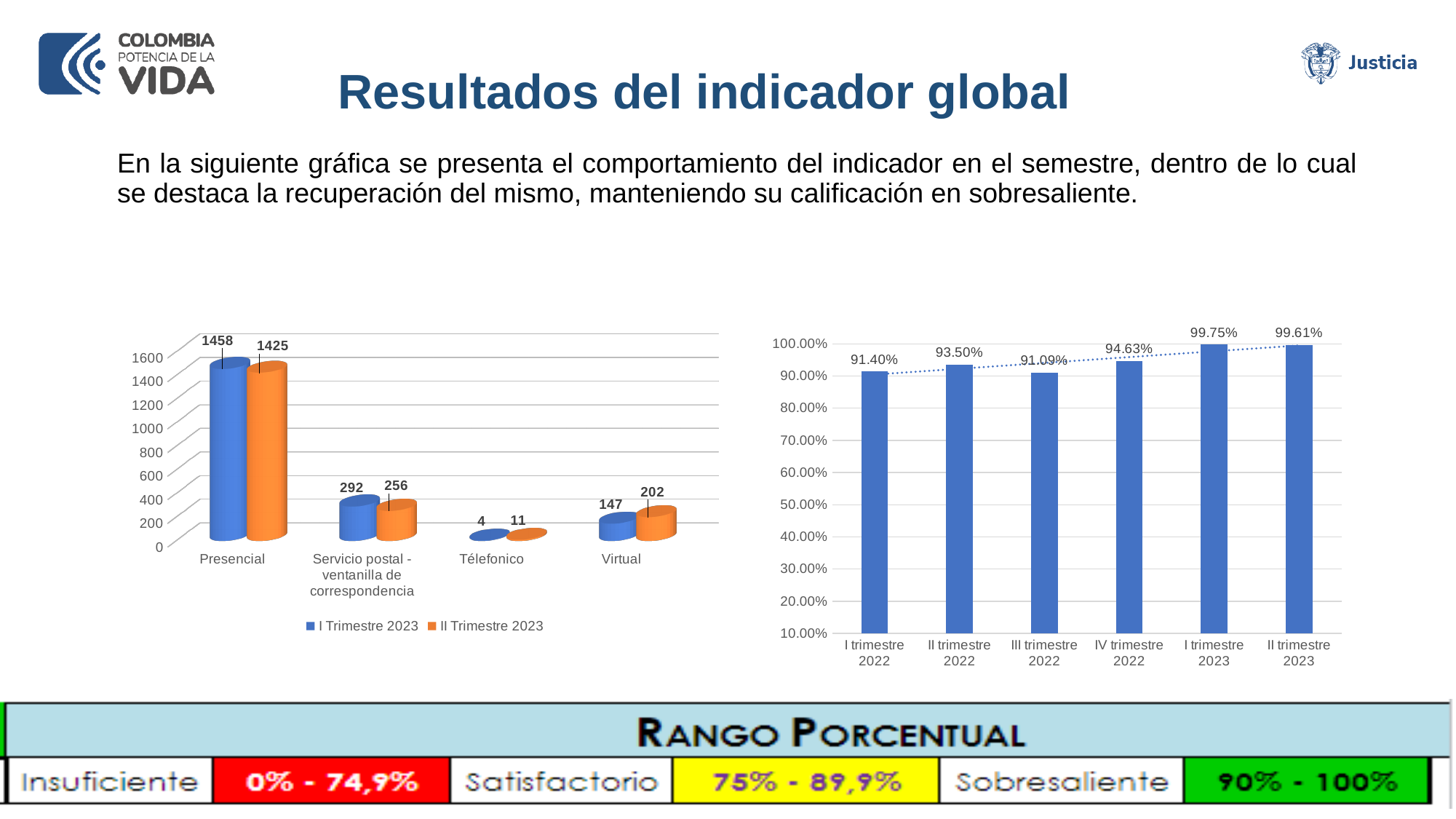
In the right chart, what is the value for I trimestre 2023? 99.75% In the left chart, which category has the lowest value in I Trimestre 2023? Télefonico In the left chart, what is the value for Presencial in I Trimestre 2023? 1458 In the left chart, what is the value for Virtual in II Trimestre 2023? 202 How many series does the legend of the left chart list? 2 In the left chart, what is the difference between the I Trimestre 2023 and II Trimestre 2023 values for Servicio postal - ventanilla de correspondencia? 36 How many categories are shown on the x axis of the left chart? 4 In the right chart, which quarter has the lowest value? III trimestre 2022 In the left chart, which is larger for Virtual: I Trimestre 2023 or II Trimestre 2023? II Trimestre 2023 In the left chart, which category has the highest value in II Trimestre 2023? Presencial What kind of chart is the right chart? Bar chart In the right chart, what is the difference between the values for IV trimestre 2022 and III trimestre 2022? 3.54%